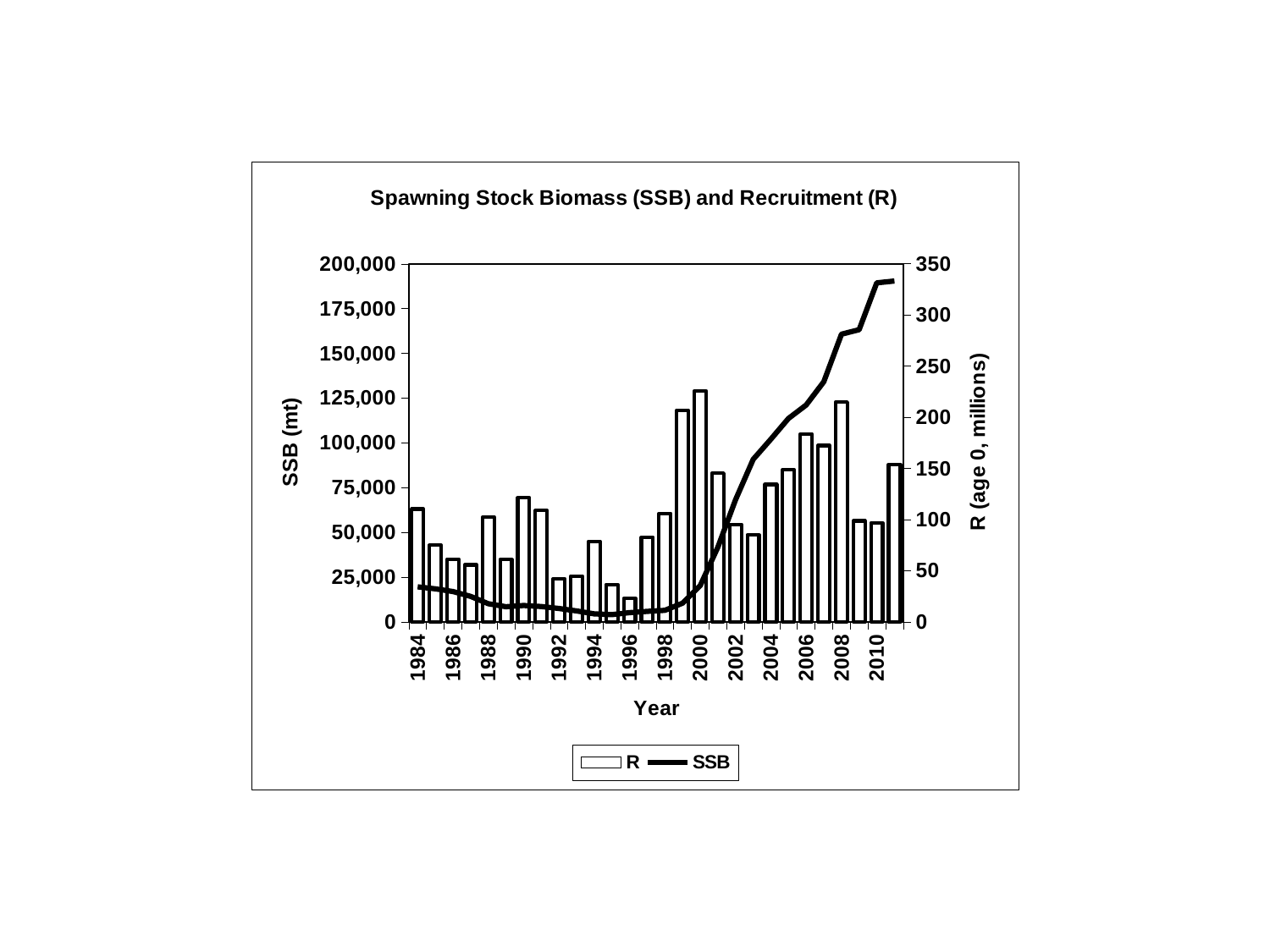
In which year is the R bar the shortest? 1996 Is the SSB value for 2011 greater or less than 175,000? greater What is the title of the chart? Spawning Stock Biomass (SSB) and Recruitment (R) Is the R value for 1996 greater or less than 50? less Which year has the larger R value, 1990 or 1992? 1990 Is the R value for 2000 greater or less than 200? greater What type of chart is shown on the slide? A combination bar and line chart Which series is drawn as bars, R or SSB? R Does the SSB line rise or fall from 2000 to 2011? Rises How many series does the legend list? 2 In which year is the R bar the tallest? 2000